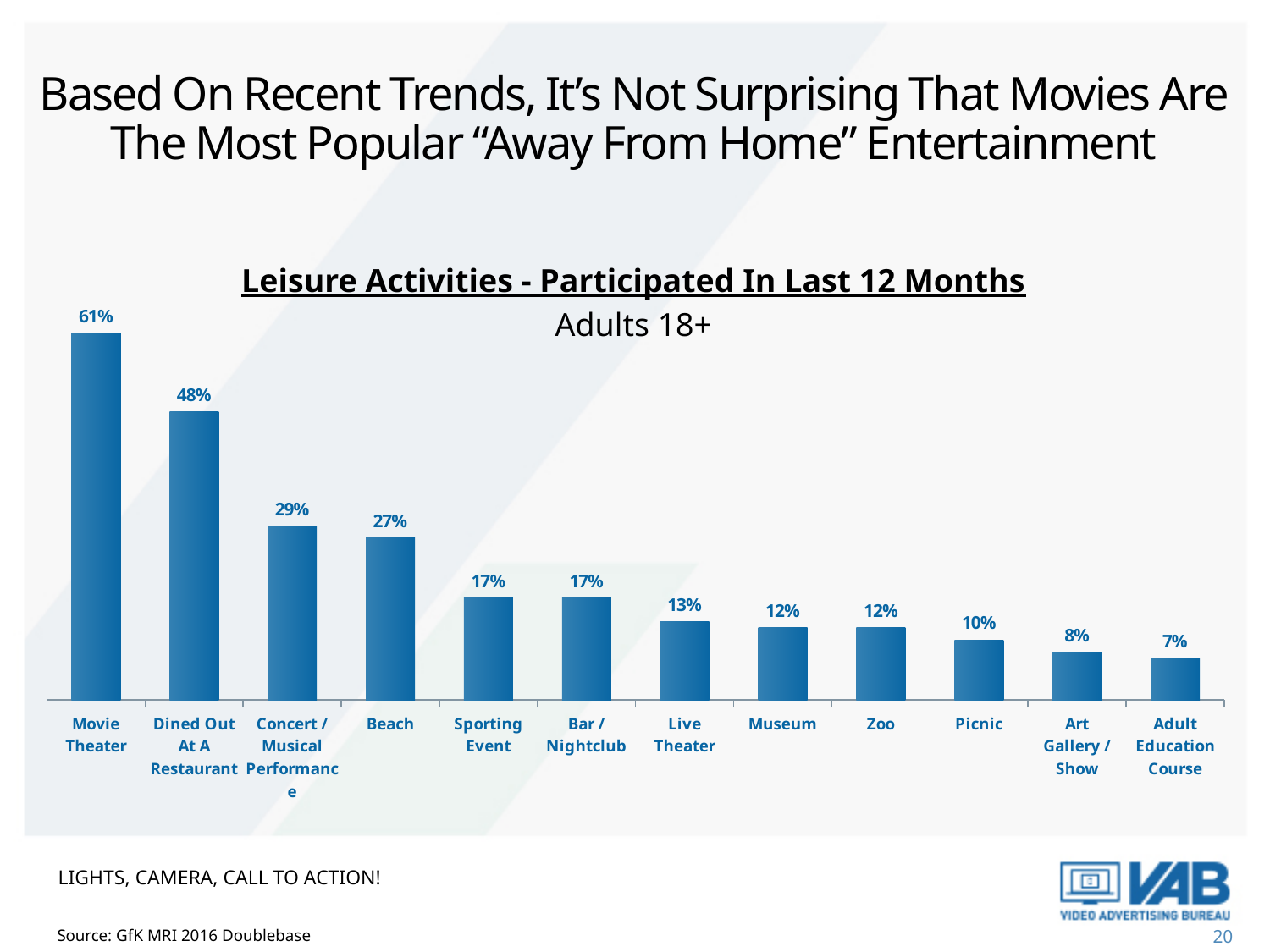
Which leisure activity has the highest participation? Movie Theater Do the values rise or fall moving from left to right across the chart? Fall Which has a higher value, Zoo or Art Gallery / Show? Zoo What percentage of adults 18+ participated in going to a movie theater in the last 12 months? 61% What is the title of the chart? Leisure Activities - Participated In Last 12 Months Which leisure activity has the lowest participation? Adult Education Course What is the value shown for Picnic? 10% How many leisure activities are shown in the chart? 12 What is the value shown for Beach? 27% What type of chart is shown on the slide? Bar chart What is the difference between the values for Concert / Musical Performance and Live Theater? 16% What is the difference between the values for Movie Theater and Dined Out At A Restaurant? 13%